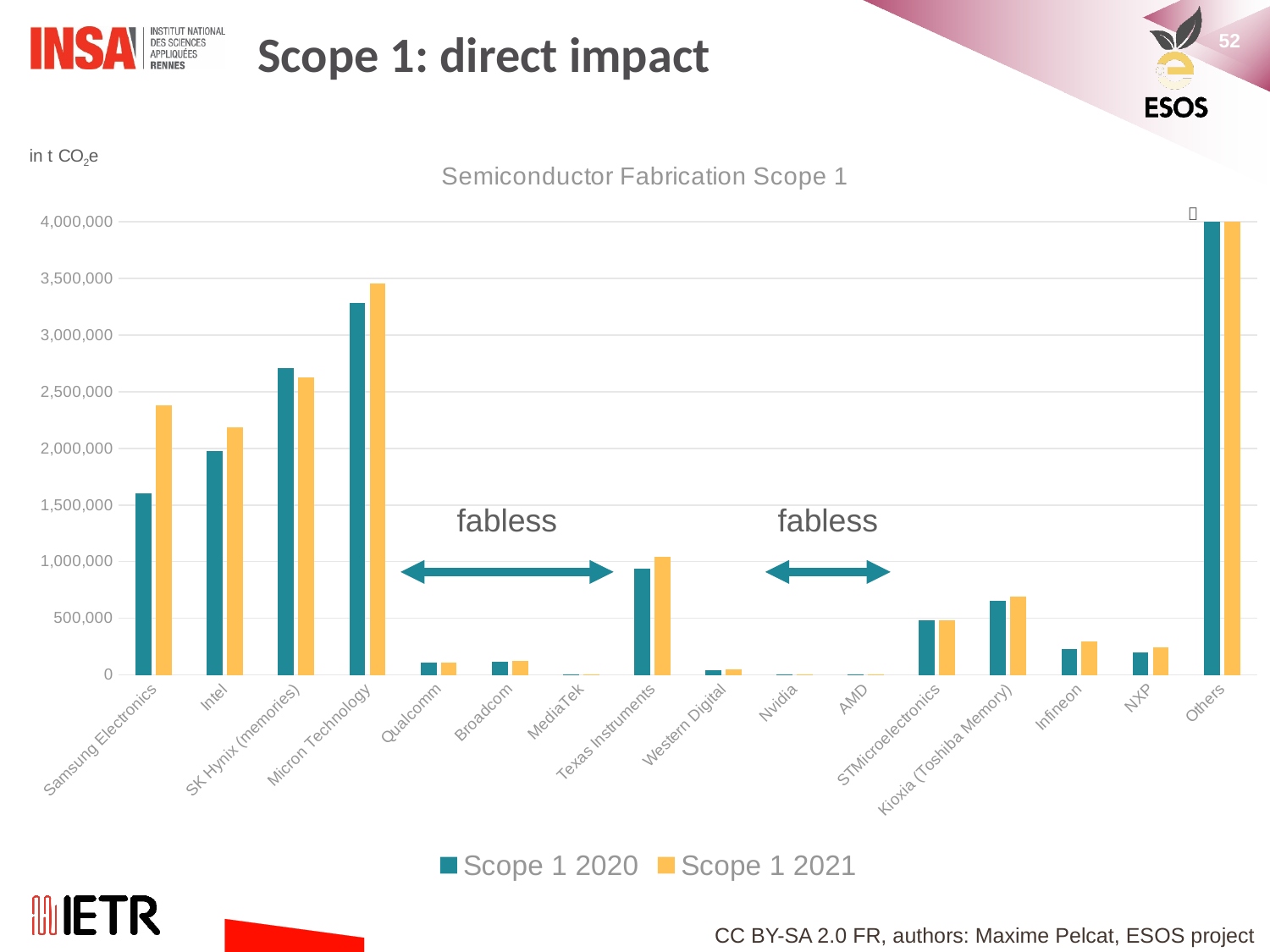
What is the title of the chart? Semiconductor Fabrication Scope 1 Which category has the highest bars in the chart? Others Is the Scope 1 2021 value for Micron Technology greater or less than 3,000,000? greater Among the named companies (excluding Others), which has the highest Scope 1 2020 value? Micron Technology For Samsung Electronics, which is larger: Scope 1 2020 or Scope 1 2021? Scope 1 2021 Is the Scope 1 2020 value for Kioxia (Toshiba Memory) greater or less than 500,000? greater What kind of chart is shown on the slide? bar chart For Scope 1 2020, which is larger: Intel or SK Hynix (memories)? SK Hynix (memories) Is the Scope 1 2021 value for Samsung Electronics greater or less than 2,000,000? greater How many series does the legend of the chart list? 2 How many categories are shown on the x axis of the chart? 16